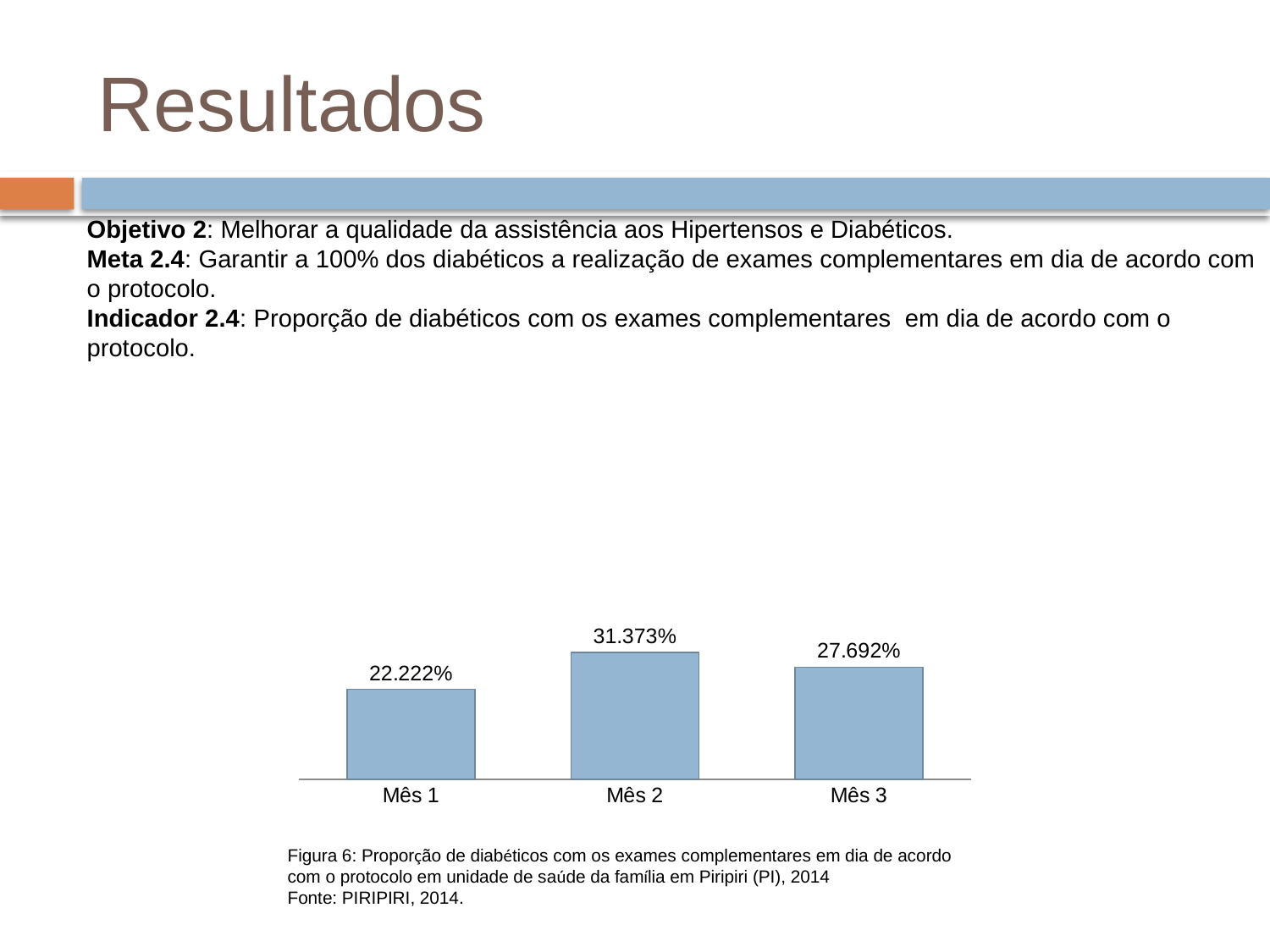
Which month has the highest value? Mês 2 What is the value for Mês 3? 27.692% What is the value for Mês 2? 31.373% What kind of chart is shown on the slide? Bar chart How many months are shown on the chart? 3 What is the difference between the values for Mês 2 and Mês 1? 9.151% Which month has the lowest value? Mês 1 What is the figure number given in the caption below the chart? Figura 6 Which is larger, the value for Mês 3 or the value for Mês 1? Mês 3 What is the difference between the values for Mês 2 and Mês 3? 3.681% Does the value rise or fall from Mês 2 to Mês 3? Fall What is the value for Mês 1? 22.222%